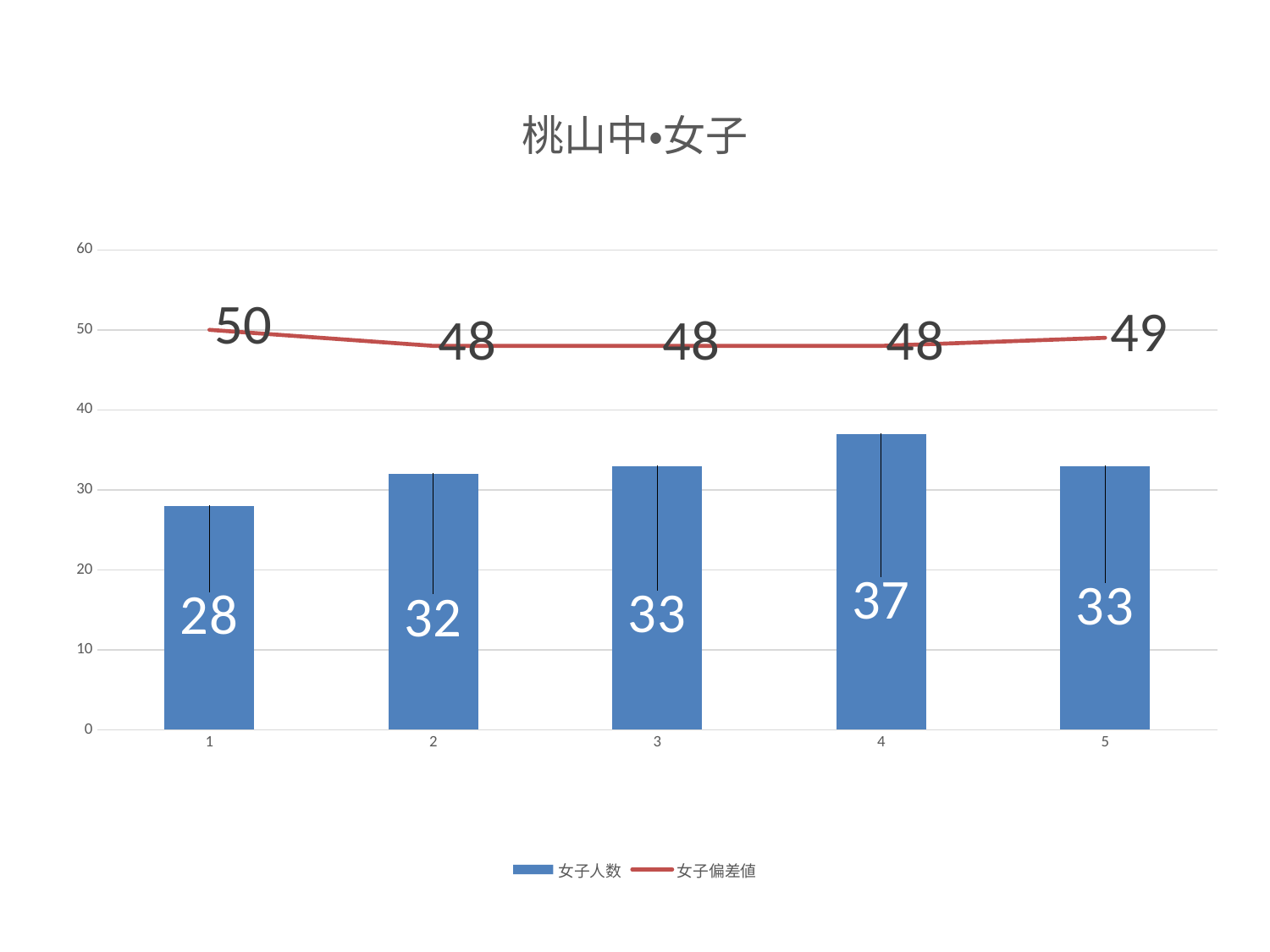
Is the value of 女子人数 for category 4 greater or less than 30? greater What is the value of 女子人数 for category 1? 28 What colour is the 女子偏差値 line? red How many series does the legend list? 2 What is the title of the chart? 桃山中•女子 What is the difference in 女子人数 between category 4 and category 1? 9 What is the value of 女子偏差値 for category 1? 50 How many categories are shown on the x axis? 5 Which category has the highest 女子人数? 4 What is the value of 女子人数 for category 4? 37 Which category has the lowest 女子人数? 1 Which is larger, 女子人数 for category 2 or for category 3? category 3